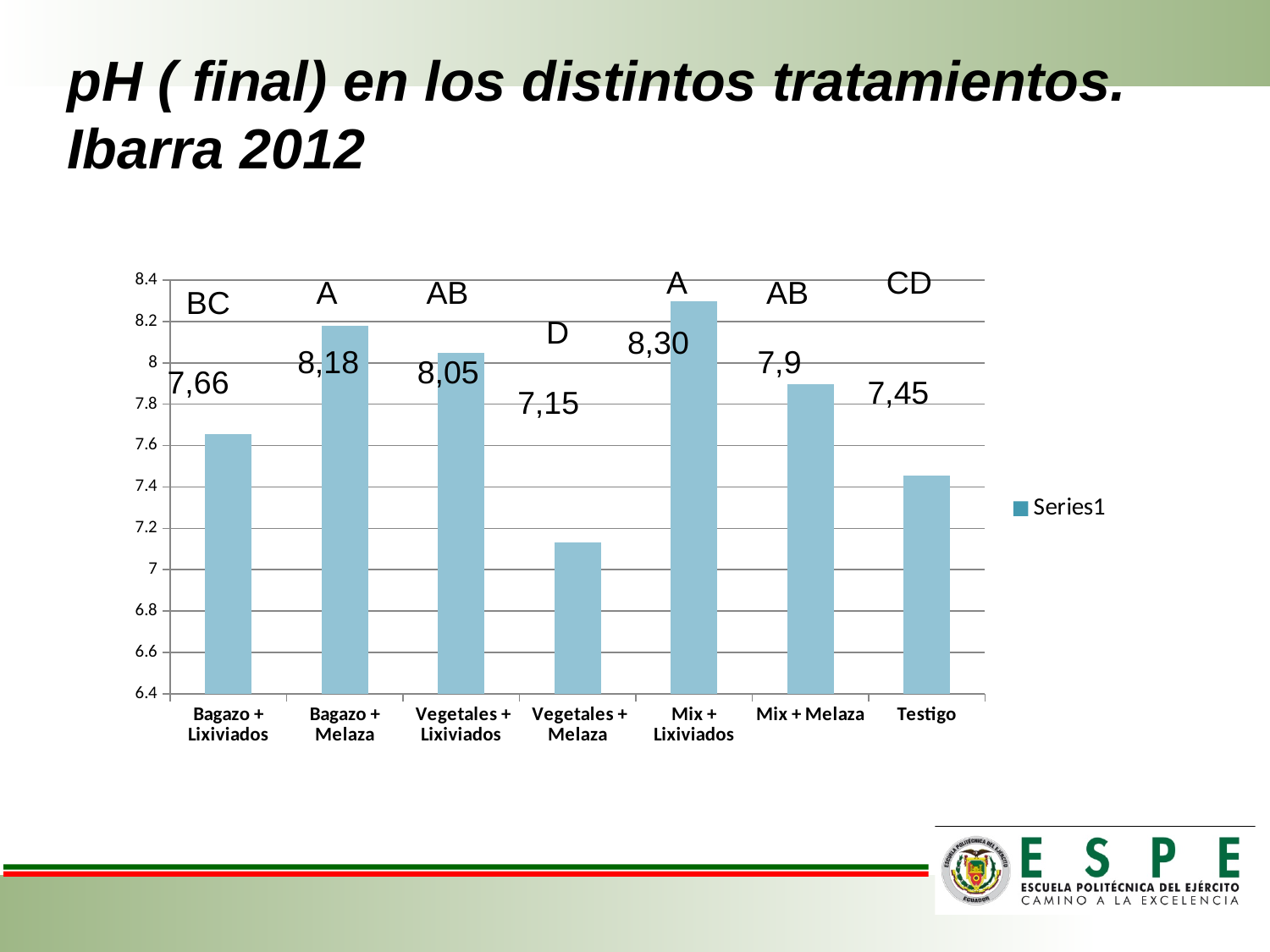
What is the difference between the pH values of Bagazo + Melaza and Vegetales + Lixiviados? 0,13 What kind of chart is shown on the slide? bar chart Is the value for Vegetales + Melaza greater or less than 7.2? less Which treatment has the lowest pH value? Vegetales + Melaza What is the pH value for Mix + Melaza? 7,9 How many treatments are shown on the x axis? 7 Which treatment has the highest pH value? Mix + Lixiviados What is the pH value for Bagazo + Lixiviados? 7,66 How many series does the legend list? 1 What is the pH value for Testigo? 7,45 Which has a higher pH value, Bagazo + Lixiviados or Testigo? Bagazo + Lixiviados What letter label appears above the Testigo bar? CD